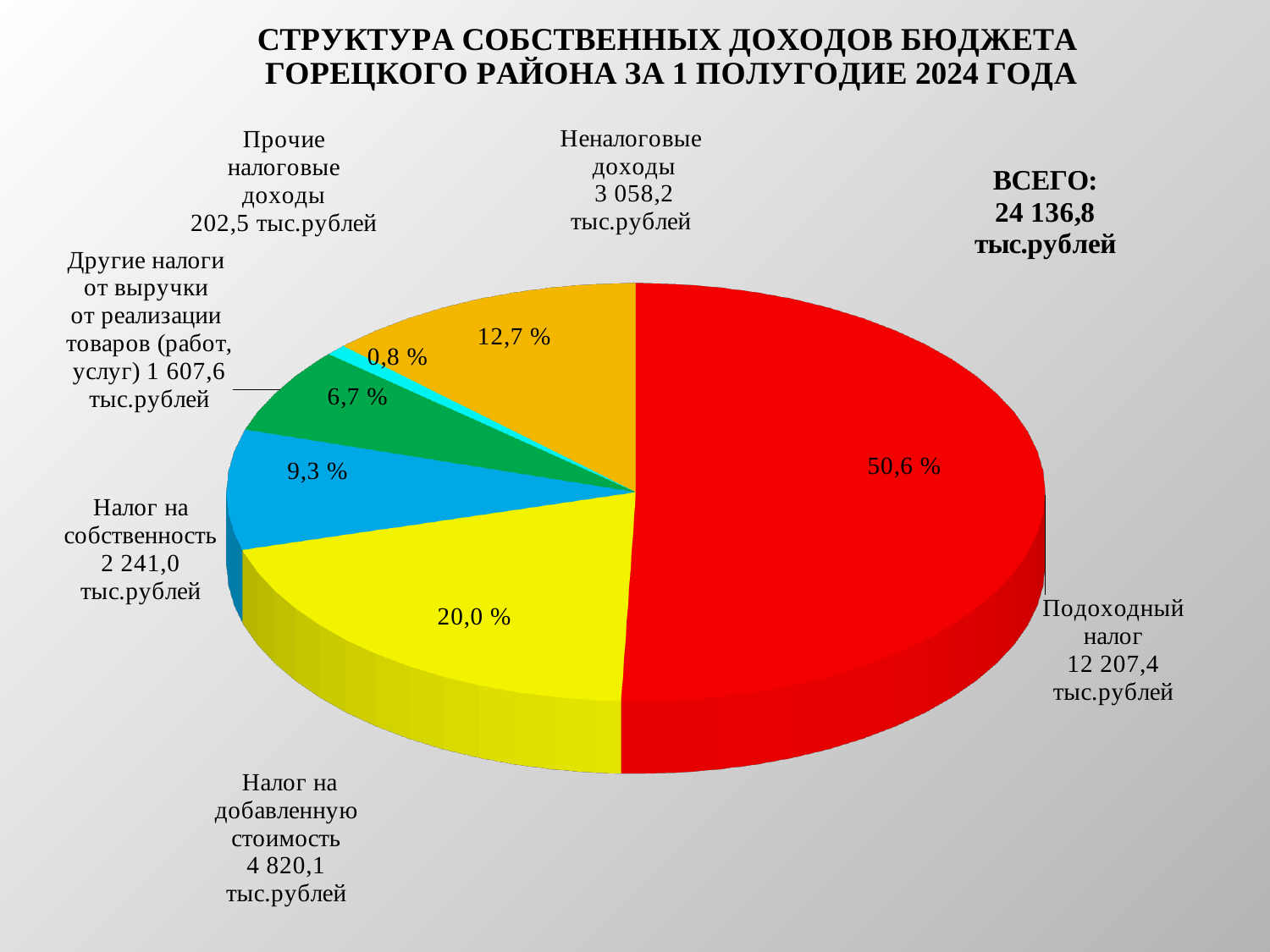
What is the value shown for Налог на собственность? 2 241,0 тыс.рублей What is the value shown for Налог на добавленную стоимость? 4 820,1 тыс.рублей Which category has the smallest share of the pie? Прочие налоговые доходы What is the difference in percentage points between the share for Налог на добавленную стоимость and the share for Налог на собственность? 10,7 What share of the pie does Подоходный налог represent? 50,6 % How many slices does the pie chart have? 6 What total (ВСЕГО) is shown on the slide? 24 136,8 тыс.рублей What is the value shown for Неналоговые доходы? 3 058,2 тыс.рублей What percentage share is shown for Налог на собственность? 9,3 % What kind of chart is shown on the slide? pie chart Which is larger: the share for Неналоговые доходы or the share for Налог на собственность? Неналоговые доходы Which category has the largest share of the pie? Подоходный налог